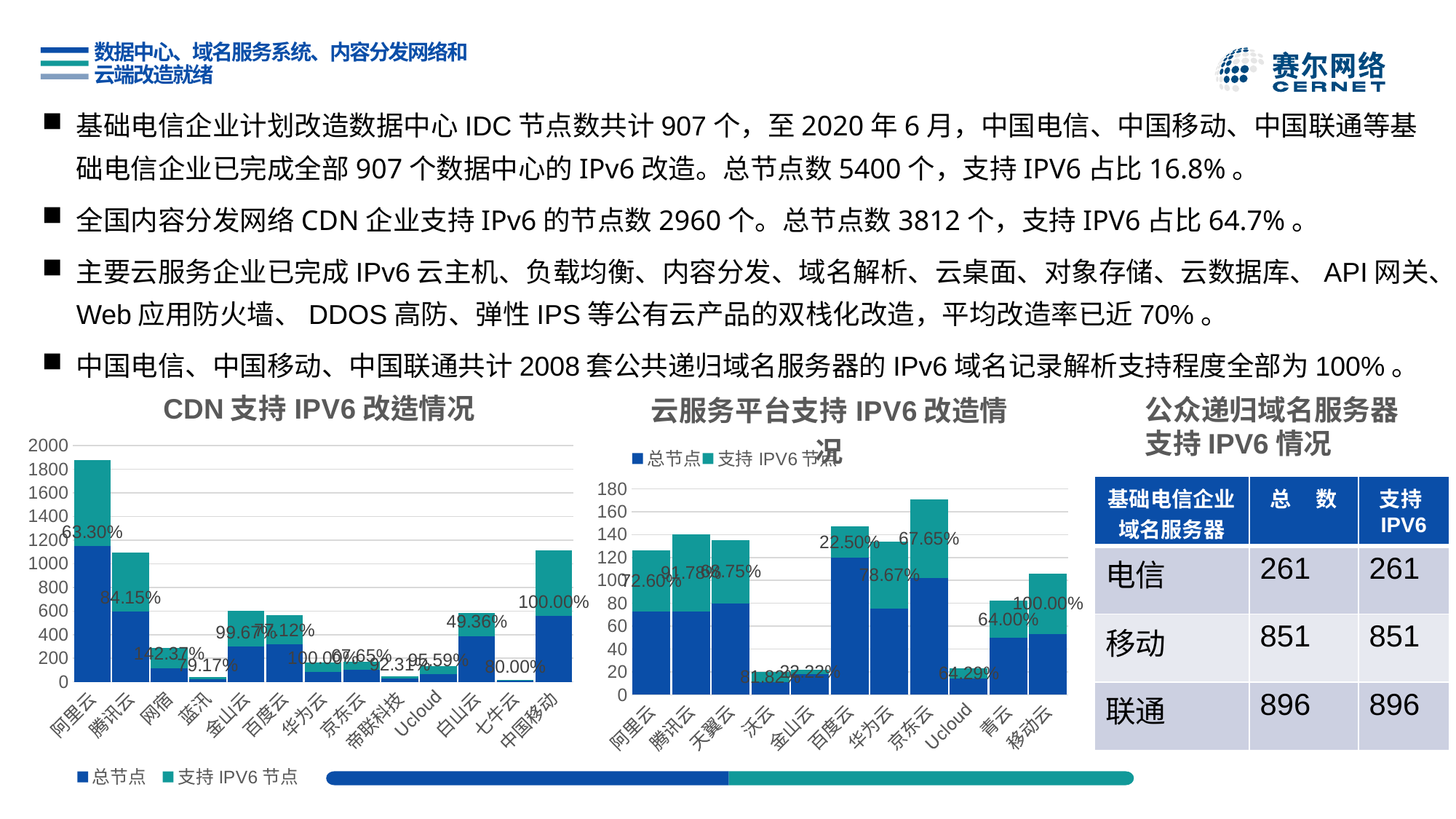
In the '云服务平台支持 IPV6 改造情况' chart, what percentage label is shown for 移动云? 100.00% In the '云服务平台支持 IPV6 改造情况' chart, which has the taller stacked bar, 阿里云 or 金山云? 阿里云 In the 'CDN 支持 IPV6 改造情况' chart, is the top of the stacked bar for 阿里云 greater or less than 1800? greater In the '云服务平台支持 IPV6 改造情况' chart, what percentage label is shown for 金山云? 22.22% In the 'CDN 支持 IPV6 改造情况' chart, what percentage label is shown for 白山云? 49.36% In the '云服务平台支持 IPV6 改造情况' chart, which company has the tallest stacked bar? 京东云 In the 'CDN 支持 IPV6 改造情况' chart, what percentage label is shown for 阿里云? 63.30% In the 'CDN 支持 IPV6 改造情况' chart, how many companies are shown on the x axis? 13 In the '云服务平台支持 IPV6 改造情况' chart, how many companies are shown on the x axis? 11 In the 'CDN 支持 IPV6 改造情况' chart, which company has the tallest stacked bar? 阿里云 In the 'CDN 支持 IPV6 改造情况' chart, how many series does the legend list? 2 What kind of chart is the 'CDN 支持 IPV6 改造情况' chart? bar chart